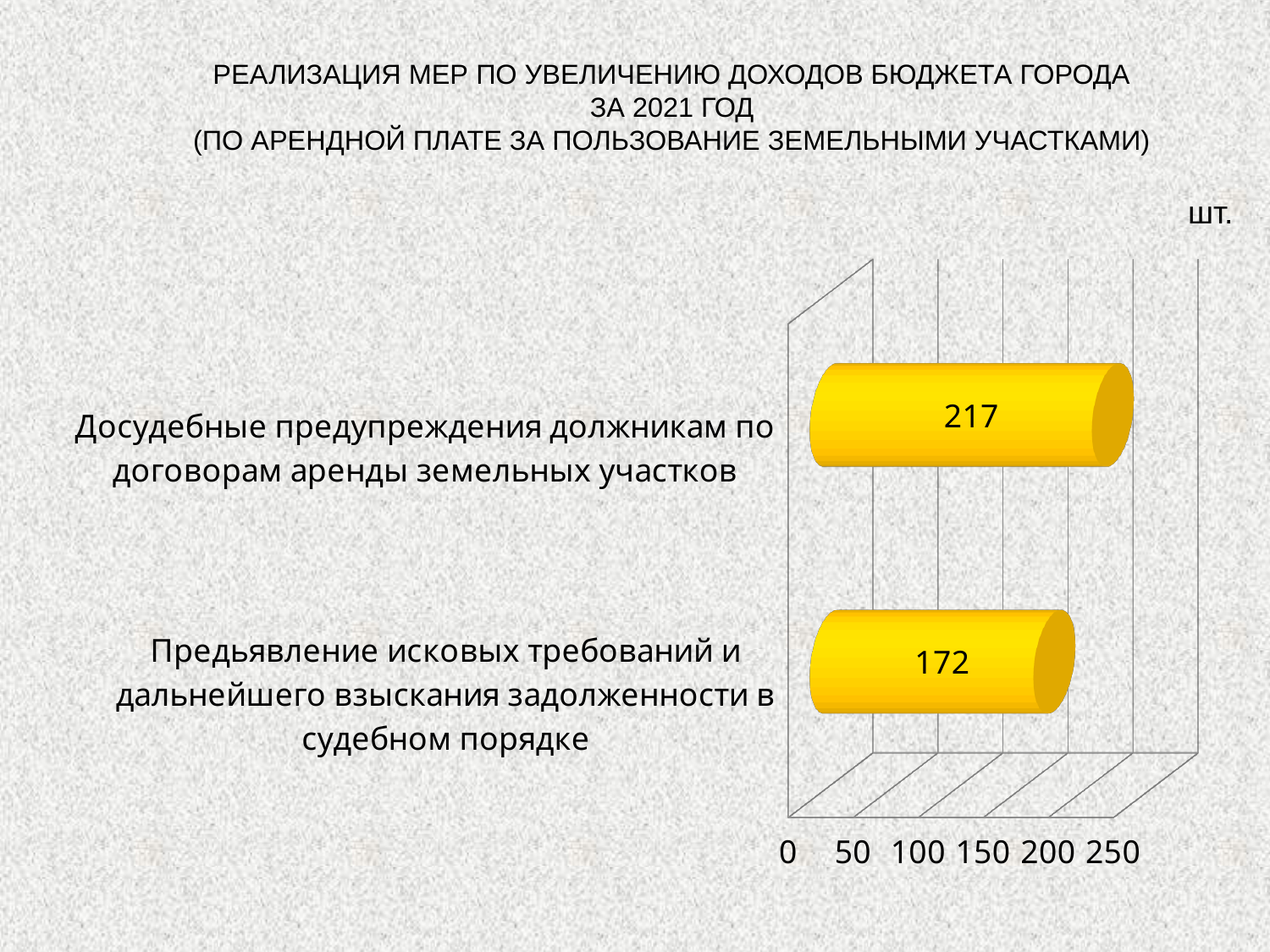
What unit label is shown above the chart? шт. Is the value for "Досудебные предупреждения должникам по договорам аренды земельных участков" greater or less than 200? greater What is the highest tick value shown on the value axis? 250 Which is larger: the value for "Досудебные предупреждения должникам по договорам аренды земельных участков" or the value for "Предьявление исковых требований и дальнейшего взыскания задолженности в судебном порядке"? Досудебные предупреждения должникам по договорам аренды земельных участков What is the difference between the value for "Досудебные предупреждения должникам по договорам аренды земельных участков" and the value for "Предьявление исковых требований и дальнейшего взыскания задолженности в судебном порядке"? 45 What is the value for "Досудебные предупреждения должникам по договорам аренды земельных участков"? 217 Which category has the lowest value? Предьявление исковых требований и дальнейшего взыскания задолженности в судебном порядке Is the value for "Предьявление исковых требований и дальнейшего взыскания задолженности в судебном порядке" greater or less than 200? less What kind of chart is shown on the slide? bar chart What is the value for "Предьявление исковых требований и дальнейшего взыскания задолженности в судебном порядке"? 172 Which category has the highest value? Досудебные предупреждения должникам по договорам аренды земельных участков How many categories are shown in the chart? 2